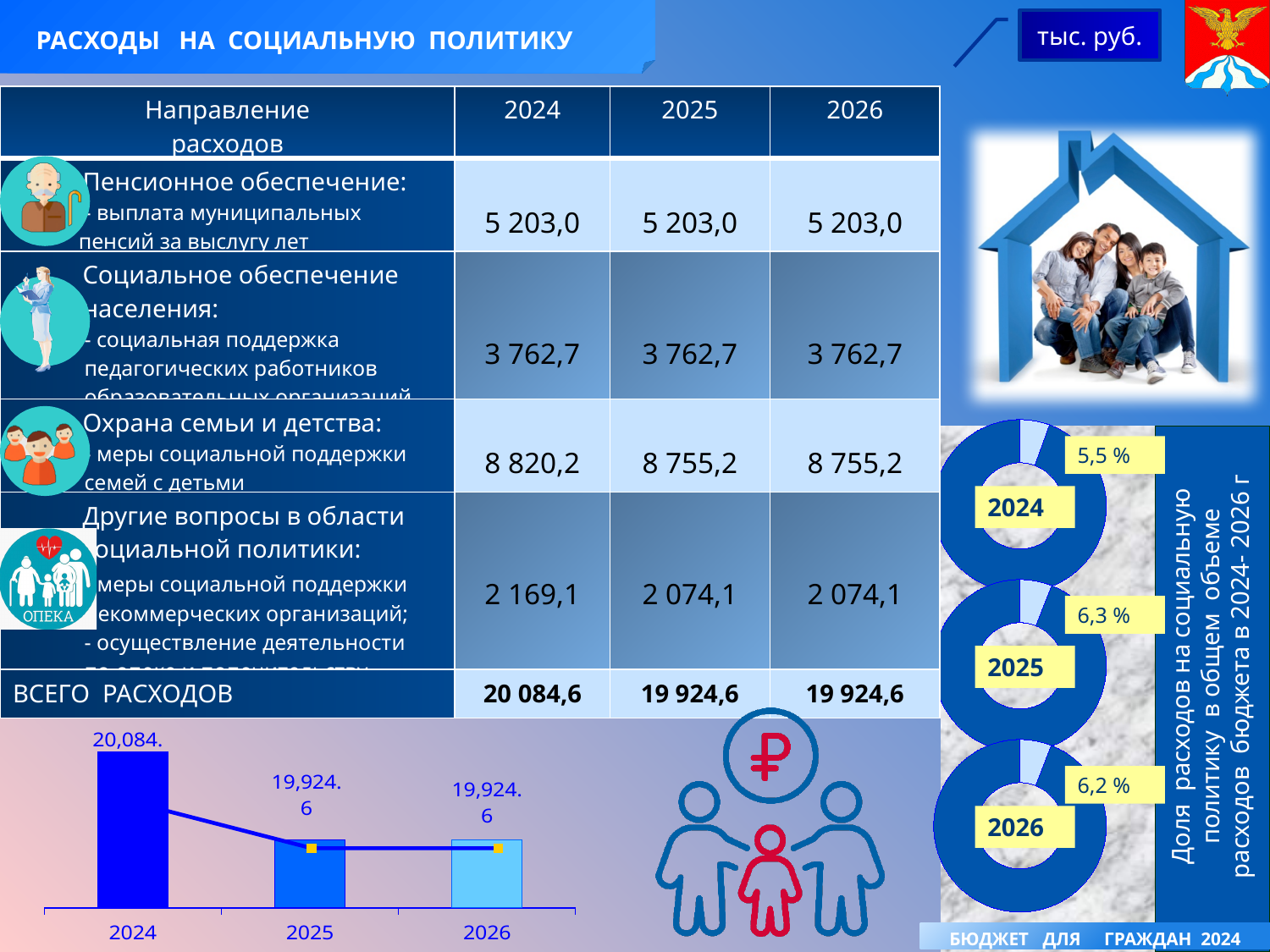
In the bar chart at the bottom left, which is larger, the value for 2024 or the value for 2025? 2024 In the donut charts on the right, what share is shown for 2025? 6,3 % In the bar chart at the bottom left, what is the difference between the values for 2025 and 2026? 0 In the bar chart at the bottom left, what is the value shown for 2025? 19,924.6 What kind of chart is shown at the bottom left of the slide? bar chart In the bar chart at the bottom left, which year has the highest bar? 2024 In the bar chart at the bottom left, what is the value shown for 2026? 19,924.6 In the donut charts on the right, what share is shown for 2024? 5,5 % How many bars are in the bar chart at the bottom left? 3 In the bar chart at the bottom left, do the values rise or fall from 2024 to 2026? fall In the donut charts on the right, which year has the lowest share? 2024 In the donut charts on the right, which year has the highest share? 2025